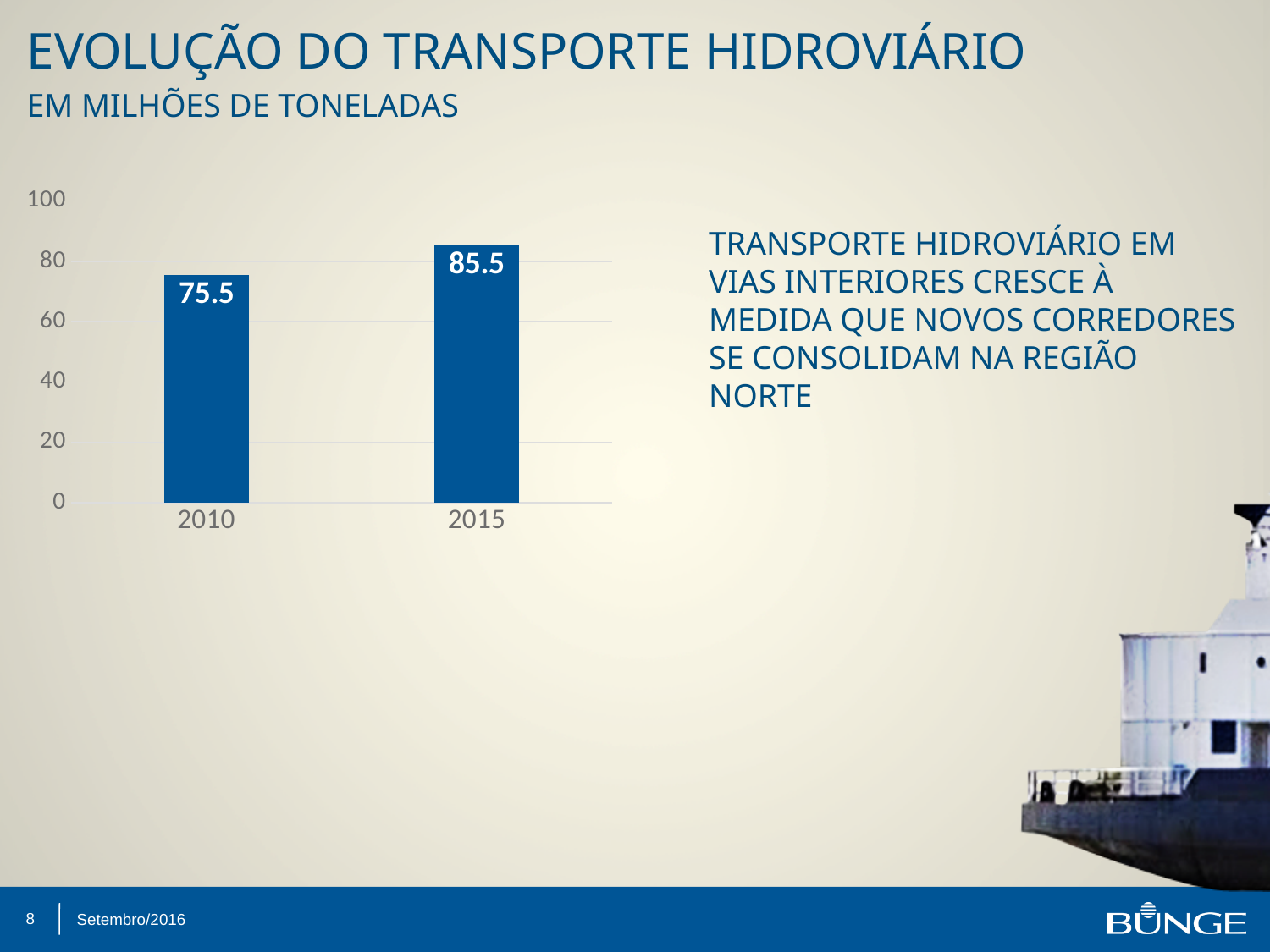
What is the maximum value shown on the y axis? 100 Which year has the higher value? 2015 Do the values rise or fall from 2010 to 2015? Rise Is the value for 2010 greater or less than 80? less Which year has the lower value? 2010 What kind of chart is shown on the slide? Bar chart What is the value for 2010? 75.5 How many years are shown on the x axis? 2 What is the value for 2015? 85.5 Is the value for 2015 greater or less than 80? greater Is the value for 2010 larger than the value for 2015? No What is the difference between the values for 2015 and 2010? 10